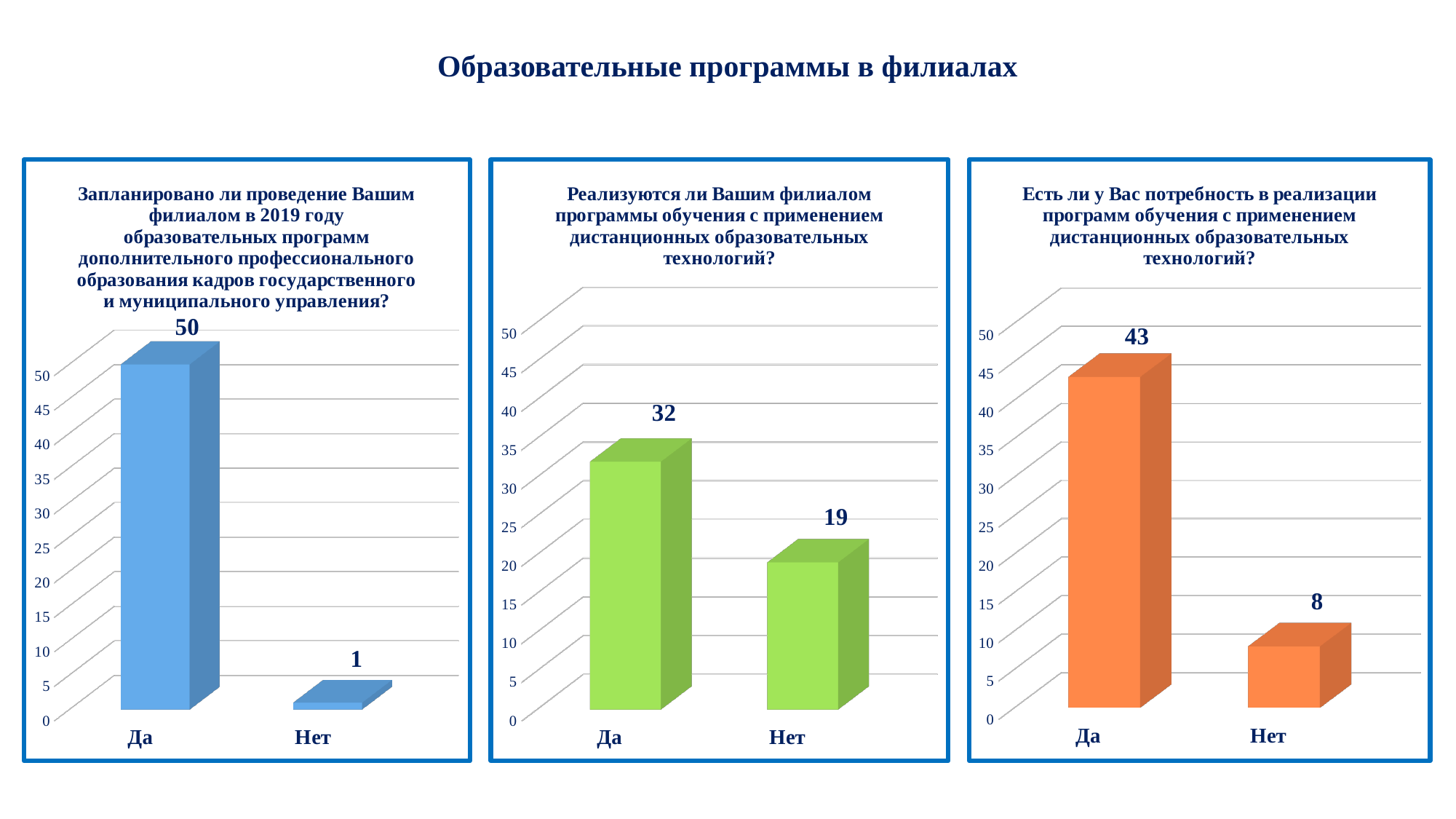
In the right chart (need for distance learning technologies), what is the difference between "Да" and "Нет"? 35 How many categories does the middle chart (distance learning technologies implemented) show? 2 What is the title of the slide? Образовательные программы в филиалах In the middle chart (distance learning technologies implemented), what is the value for "Да"? 32 In the left chart (planned 2019 educational programs), which is larger, "Да" or "Нет"? Да In the left chart (planned 2019 educational programs), what is the value for "Да"? 50 In the middle chart (distance learning technologies implemented), what is the value for "Нет"? 19 In the right chart (need for distance learning technologies), what is the value for "Нет"? 8 In the left chart (planned 2019 educational programs), what is the value for "Нет"? 1 What kind of chart is the right chart (need for distance learning technologies)? Bar chart In the middle chart (distance learning technologies implemented), what is the difference between "Да" and "Нет"? 13 In the right chart (need for distance learning technologies), which category has the highest value? Да